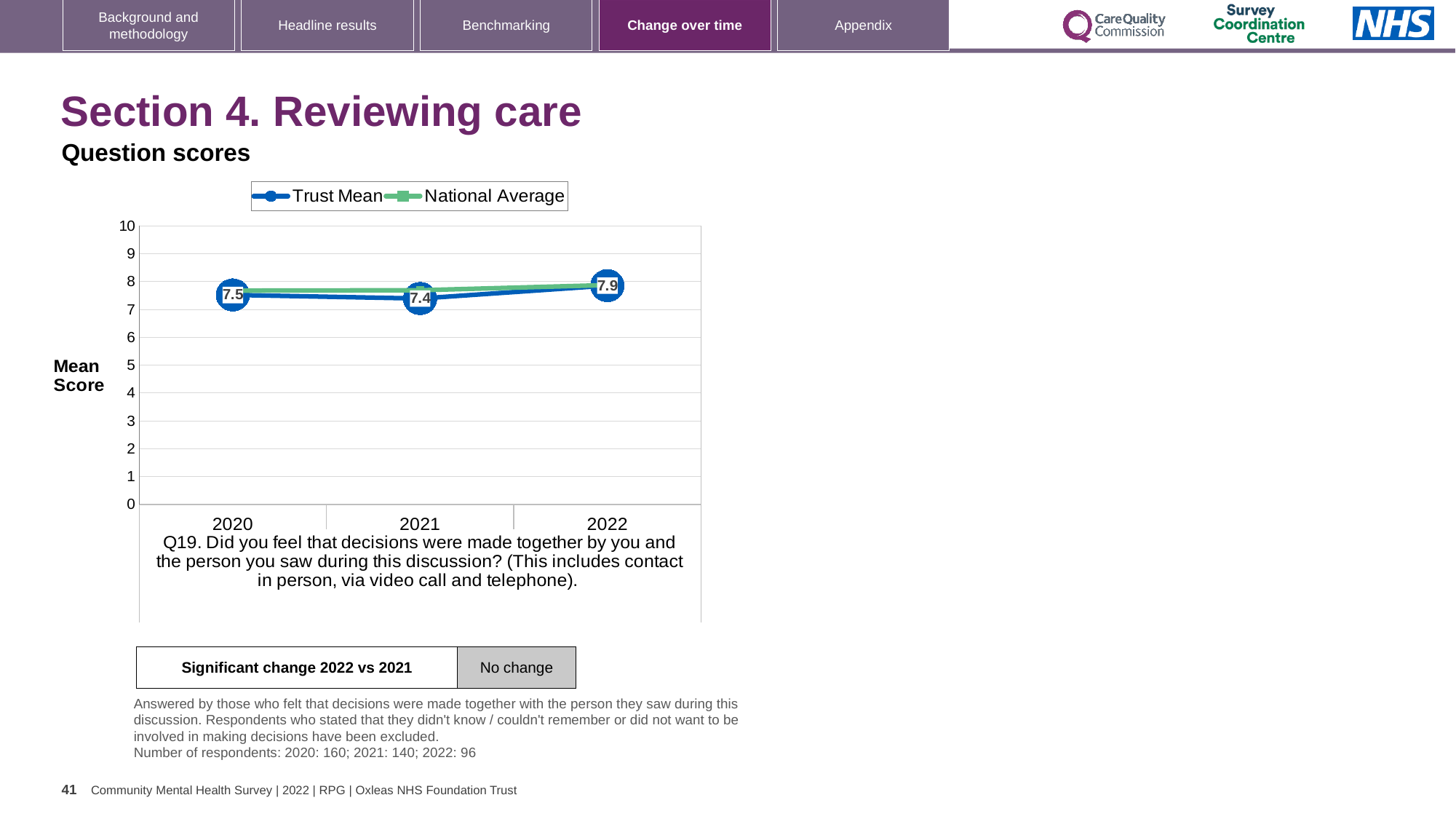
How many series does the legend list? 2 How many years are plotted on the x axis? 3 What is the Trust Mean score for 2020? 7.5 What is the Trust Mean score for 2021? 7.4 What is the Trust Mean score for 2022? 7.9 Does the Trust Mean score rise or fall from 2021 to 2022? rise Is the National Average score for 2021 greater or less than 7? greater Which is larger, the Trust Mean score for 2020 or for 2021? 2020 In which year is the Trust Mean score lowest? 2021 What is the difference between the Trust Mean scores for 2022 and 2021? 0.5 What kind of chart is shown on the slide? line chart In which year is the Trust Mean score highest? 2022